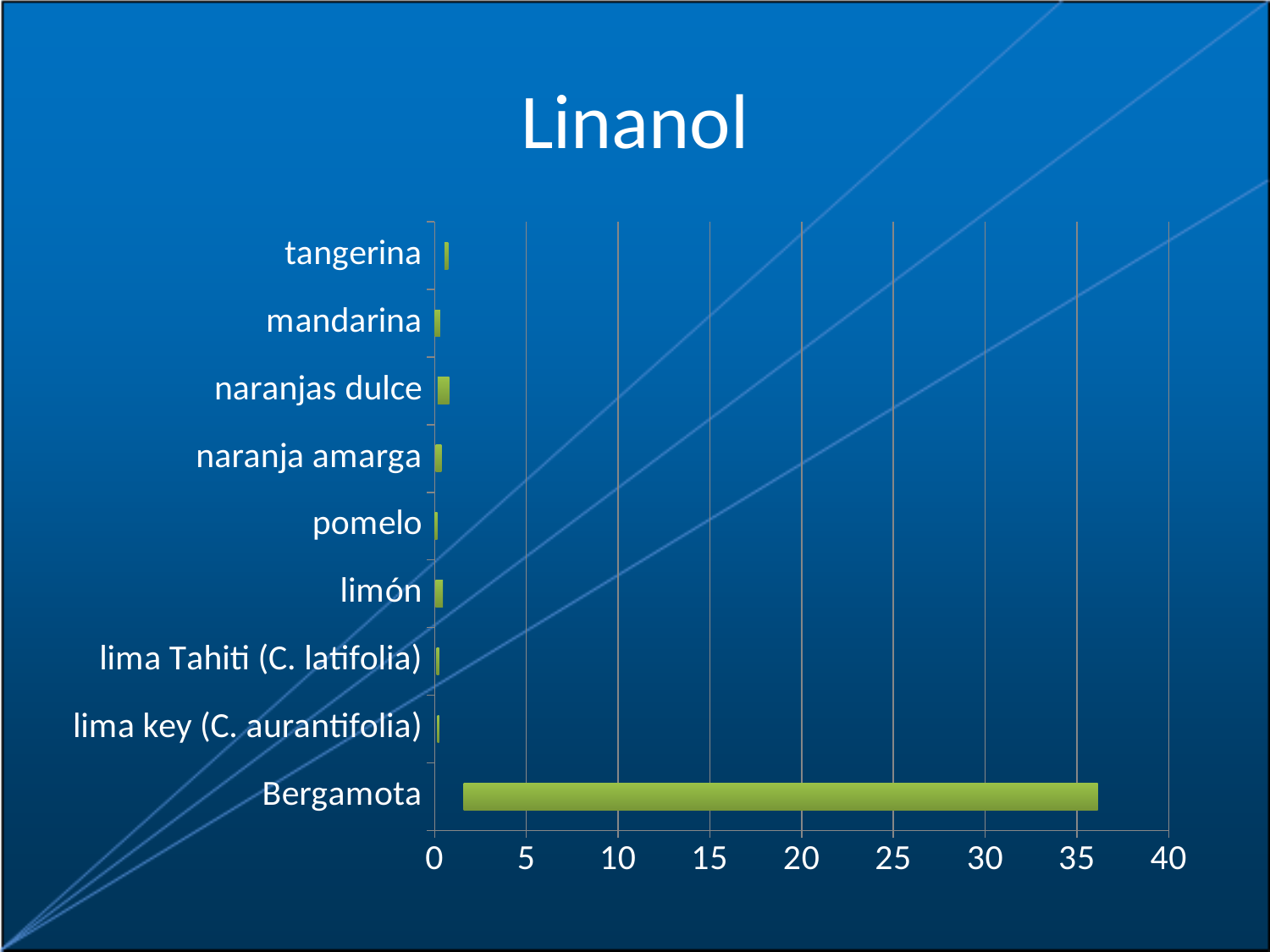
What kind of chart is shown on the slide? bar chart Is the value for limón greater or less than 5? less What is the title of the chart? Linanol Which has the larger value, Bergamota or limón? Bergamota Is the value for naranjas dulce greater or less than 5? less Is the value for Bergamota greater or less than 30? greater What is the maximum value shown on the horizontal axis? 40 How many categories are plotted in the chart? 9 Which category has the highest value in the chart? Bergamota Which has the larger value, pomelo or Bergamota? Bergamota